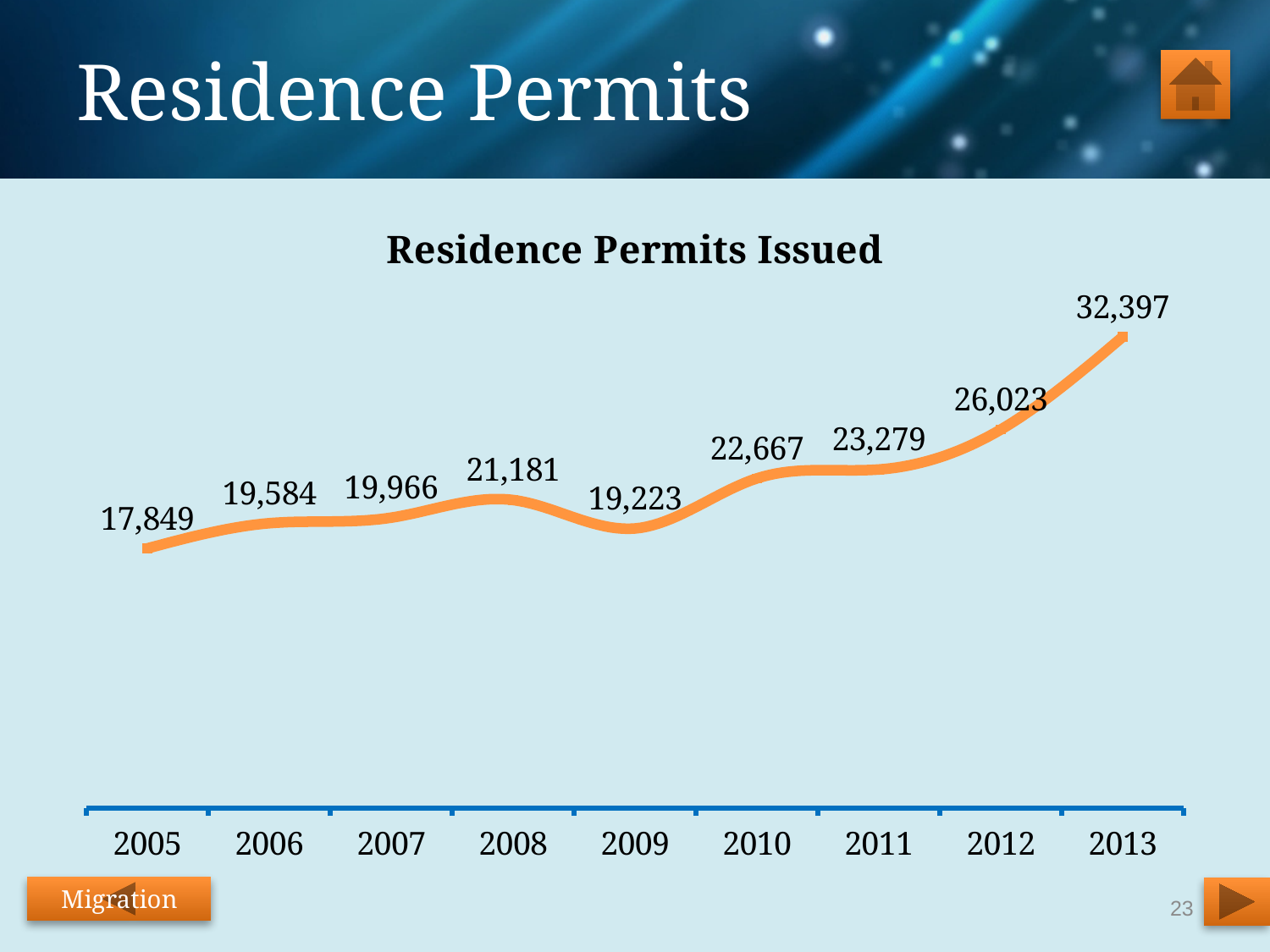
How many years are plotted on the chart? 9 What is the title of the chart? Residence Permits Issued Which year has the lowest value? 2005 What kind of chart is shown? line chart What is the value for 2009? 19,223 What is the difference between the values for 2013 and 2012? 6,374 Which is larger, the value for 2008 or the value for 2009? 2008 Which year has the highest value? 2013 What is the value for 2013? 32,397 What is the value for 2011? 23,279 What is the difference between the values for 2008 and 2009? 1,958 What is the value for 2005? 17,849